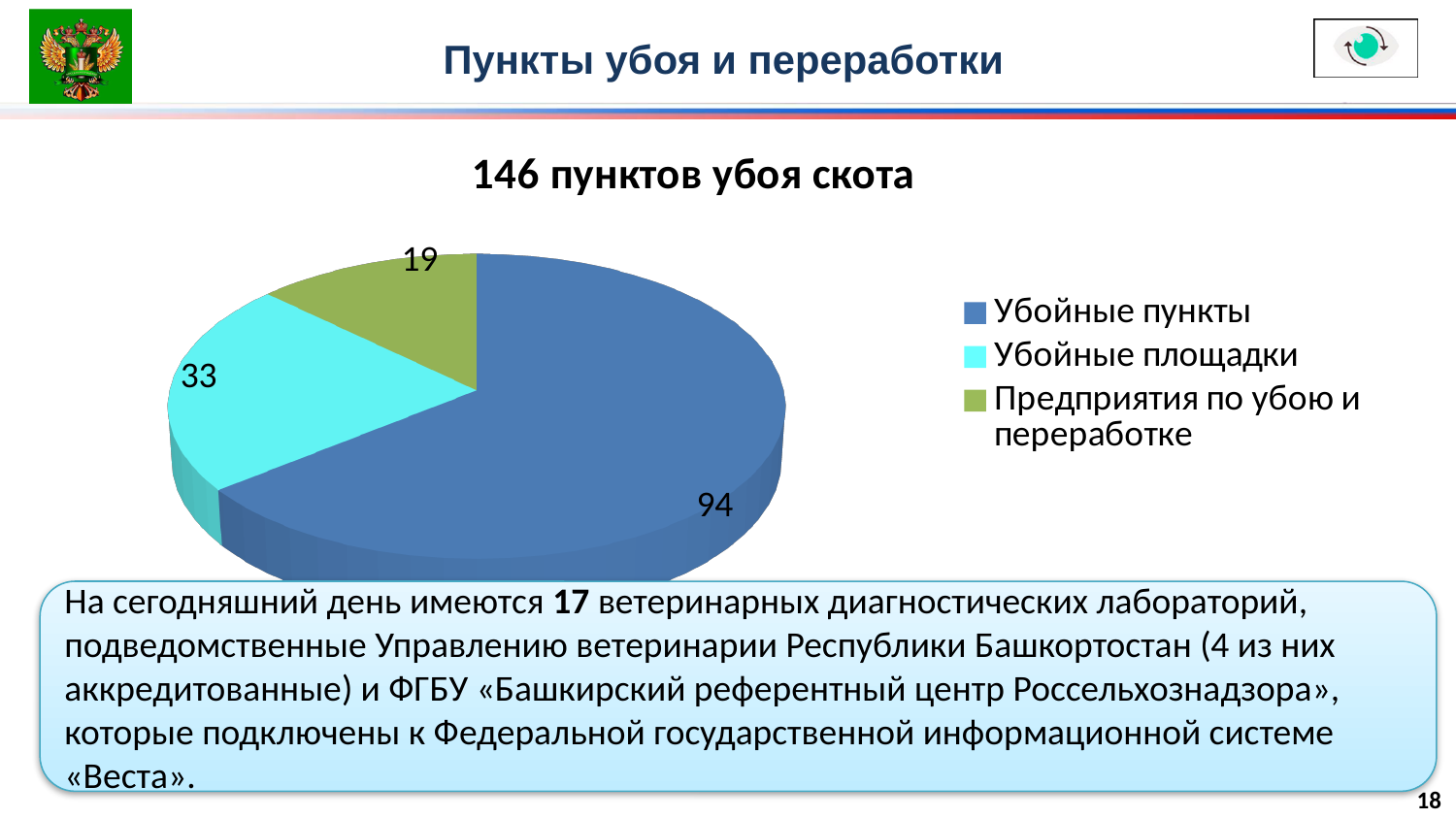
What is the value for Предприятия по убою и переработке? 19 What is the difference between the values for Убойные пункты and Убойные площадки? 61 Which category has the largest slice of the pie? Убойные пункты What is the value for Убойные пункты? 94 Which category has the smallest slice of the pie? Предприятия по убою и переработке How many categories does the pie chart have? 3 What type of chart is shown on the slide? pie chart Which is larger, Убойные площадки or Предприятия по убою и переработке? Убойные площадки What is the title of the chart? 146 пунктов убоя скота What is the total of all slices in the pie chart? 146 What is the difference between the values for Убойные площадки and Предприятия по убою и переработке? 14 What is the value for Убойные площадки? 33